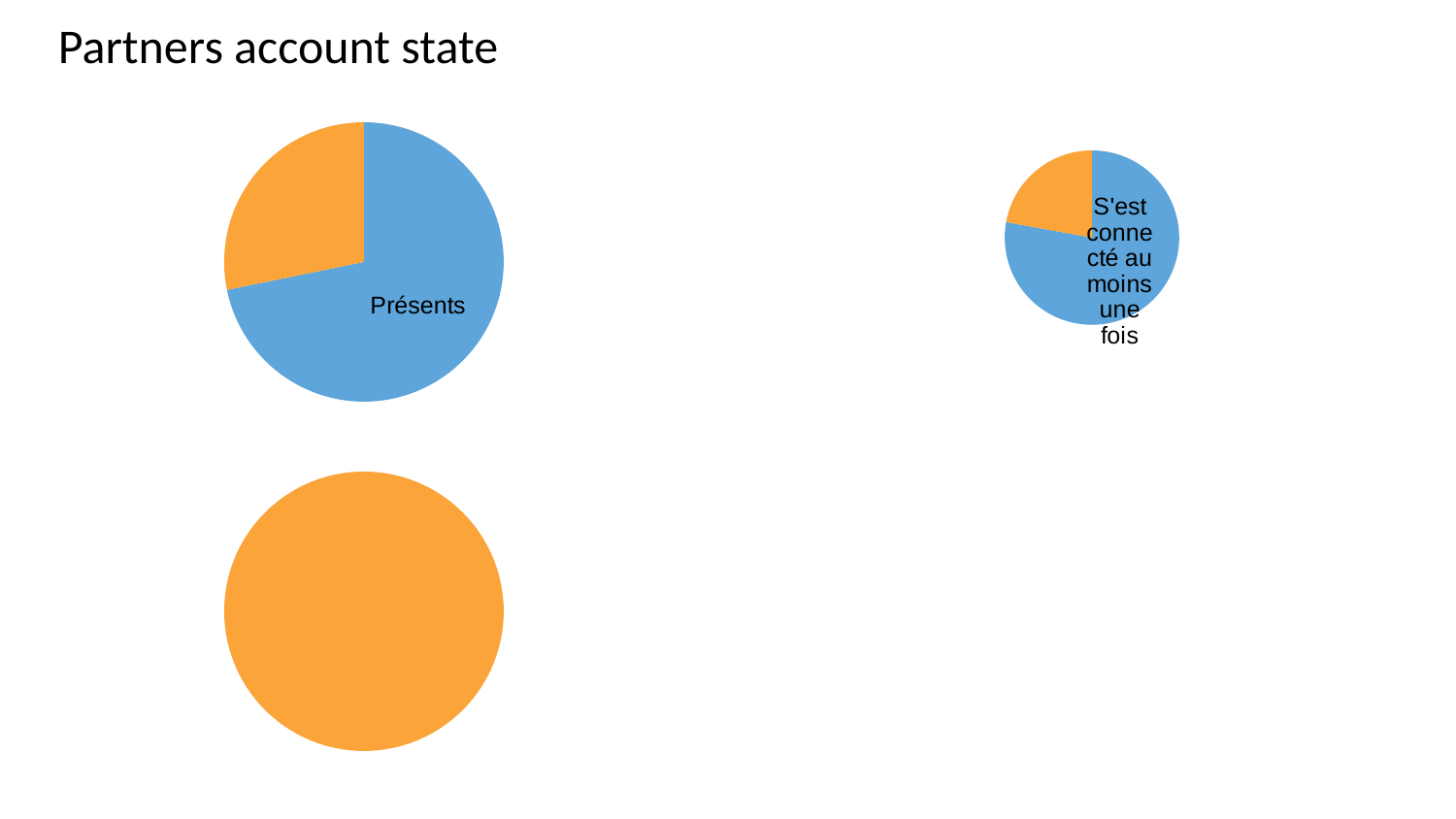
What is the label shown on the blue slice of the top-left pie chart? Présents What colour is the single slice of the bottom-left pie chart? Orange How many slices does the top-left pie chart have? 2 In the top-right pie chart, is the share of the orange slice greater or less than 50%? less In the top-left pie chart, is the share of the Présents slice greater or less than 50%? greater What kind of chart is the top-left chart on the slide? Pie chart What kind of chart is the bottom-left chart on the slide? Pie chart In the top-left pie chart, which slice is larger, the blue slice labelled Présents or the orange slice? Présents In the top-right pie chart, which slice is larger, the blue slice labelled "S'est connecté au moins une fois" or the orange slice? S'est connecté au moins une fois What kind of chart is the top-right chart on the slide? Pie chart How many slices does the bottom-left pie chart have? 1 How many slices does the top-right pie chart have? 2